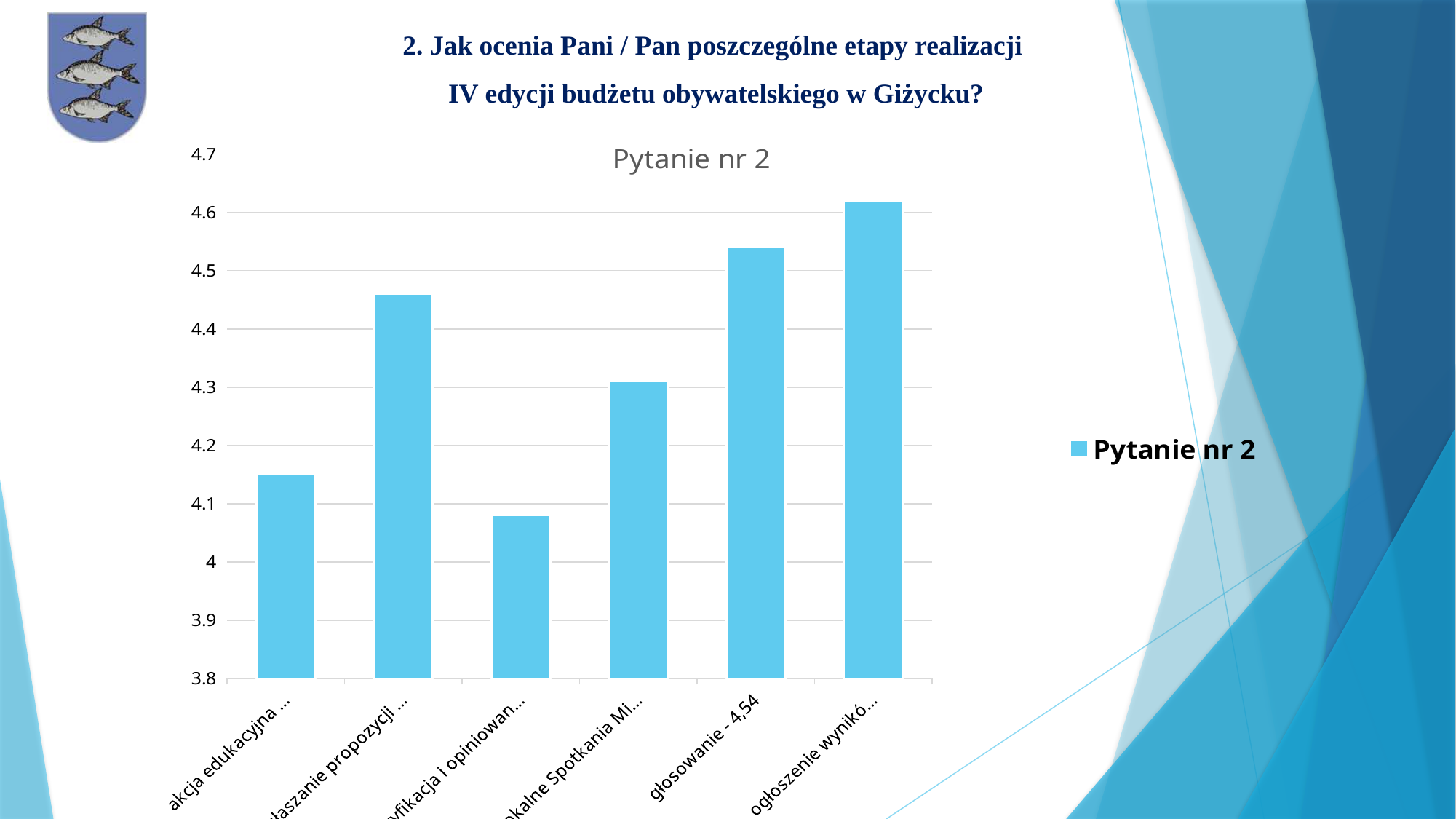
Is the value of the rightmost bar greater or less than 4.6? greater How many bars are plotted in the chart? 6 Which bar is the lowest in the chart? the third bar from the left What value is given for the category 'głosowanie'? 4,54 Is the value of the fourth bar from the left greater or less than 4.4? less Which bar is the highest in the chart? the rightmost bar (ogłoszenie wyników) What is the title of the chart? Pytanie nr 2 Is the value of the second bar from the left greater or less than 4.4? greater What kind of chart is shown on the slide? bar chart How many series does the legend list? 1 Which is larger: the value for 'głosowanie' or the value of the leftmost bar? głosowanie